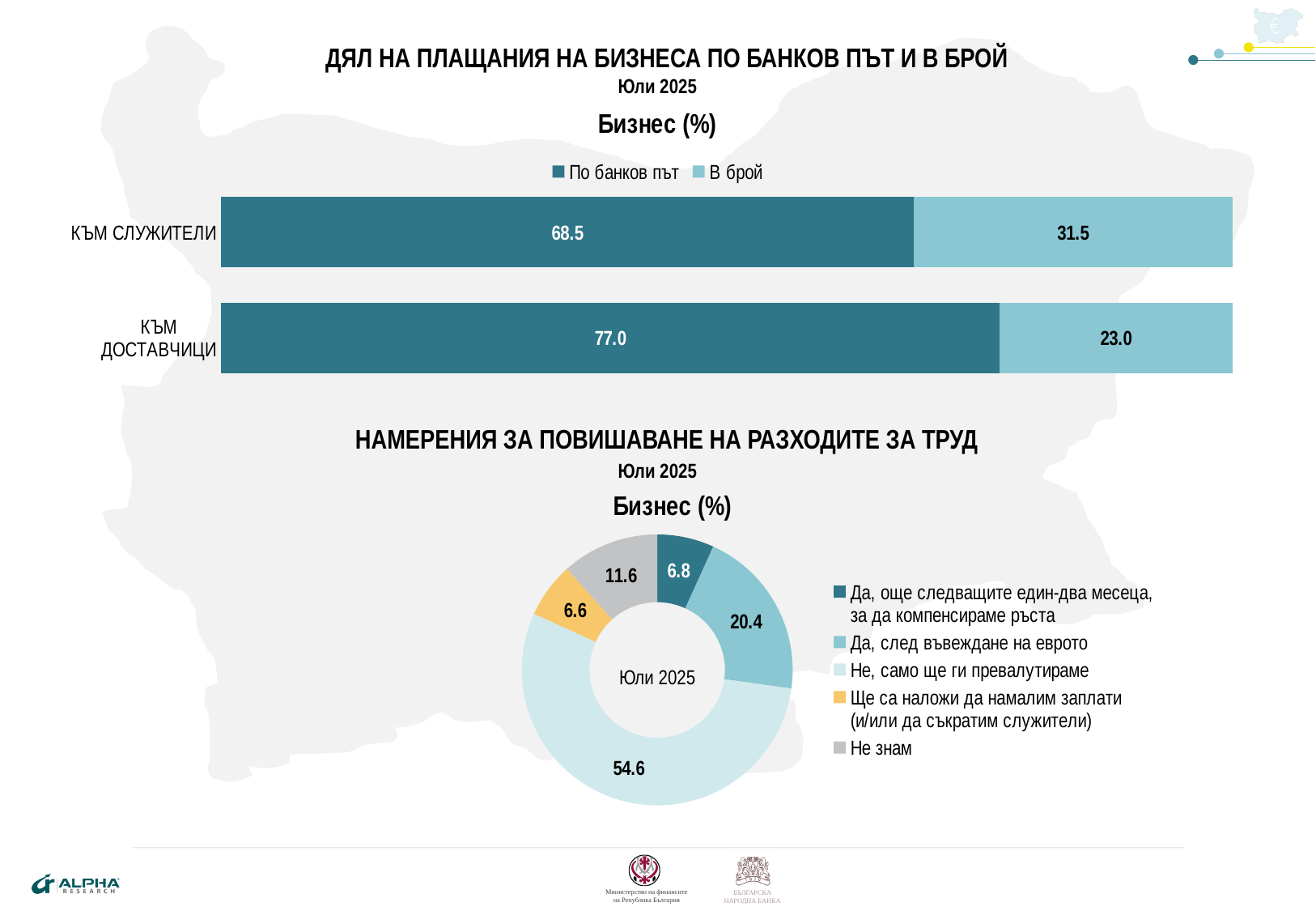
In the top chart 'ДЯЛ НА ПЛАЩАНИЯ НА БИЗНЕСА ПО БАНКОВ ПЪТ И В БРОЙ', which category has the higher 'В брой' value, 'КЪМ СЛУЖИТЕЛИ' or 'КЪМ ДОСТАВЧИЦИ'? КЪМ СЛУЖИТЕЛИ In the top chart 'ДЯЛ НА ПЛАЩАНИЯ НА БИЗНЕСА ПО БАНКОВ ПЪТ И В БРОЙ', what is the difference between the 'По банков път' values for 'КЪМ ДОСТАВЧИЦИ' and 'КЪМ СЛУЖИТЕЛИ'? 8.5 How many series does the legend of the top chart 'ДЯЛ НА ПЛАЩАНИЯ НА БИЗНЕСА ПО БАНКОВ ПЪТ И В БРОЙ' list? 2 What kind of chart is the bottom chart 'НАМЕРЕНИЯ ЗА ПОВИШАВАНЕ НА РАЗХОДИТЕ ЗА ТРУД'? Doughnut chart In the top chart 'ДЯЛ НА ПЛАЩАНИЯ НА БИЗНЕСА ПО БАНКОВ ПЪТ И В БРОЙ', what is the value of 'По банков път' for 'КЪМ СЛУЖИТЕЛИ'? 68.5 In the top chart 'ДЯЛ НА ПЛАЩАНИЯ НА БИЗНЕСА ПО БАНКОВ ПЪТ И В БРОЙ', what is the total of the stacked bar for 'КЪМ СЛУЖИТЕЛИ'? 100.0 In the bottom chart 'НАМЕРЕНИЯ ЗА ПОВИШАВАНЕ НА РАЗХОДИТЕ ЗА ТРУД', how many categories are shown? 5 In the bottom chart 'НАМЕРЕНИЯ ЗА ПОВИШАВАНЕ НА РАЗХОДИТЕ ЗА ТРУД', what is the value for 'Да, след въвеждане на еврото'? 20.4 What kind of chart is the top chart 'ДЯЛ НА ПЛАЩАНИЯ НА БИЗНЕСА ПО БАНКОВ ПЪТ И В БРОЙ'? Stacked bar chart In the top chart 'ДЯЛ НА ПЛАЩАНИЯ НА БИЗНЕСА ПО БАНКОВ ПЪТ И В БРОЙ', what is the value of 'В брой' for 'КЪМ ДОСТАВЧИЦИ'? 23.0 In the bottom chart 'НАМЕРЕНИЯ ЗА ПОВИШАВАНЕ НА РАЗХОДИТЕ ЗА ТРУД', which category has the smallest value? Ще са наложи да намалим заплати (и/или да съкратим служители) In the bottom chart 'НАМЕРЕНИЯ ЗА ПОВИШАВАНЕ НА РАЗХОДИТЕ ЗА ТРУД', what is the value for 'Не, само ще ги превалутираме'? 54.6